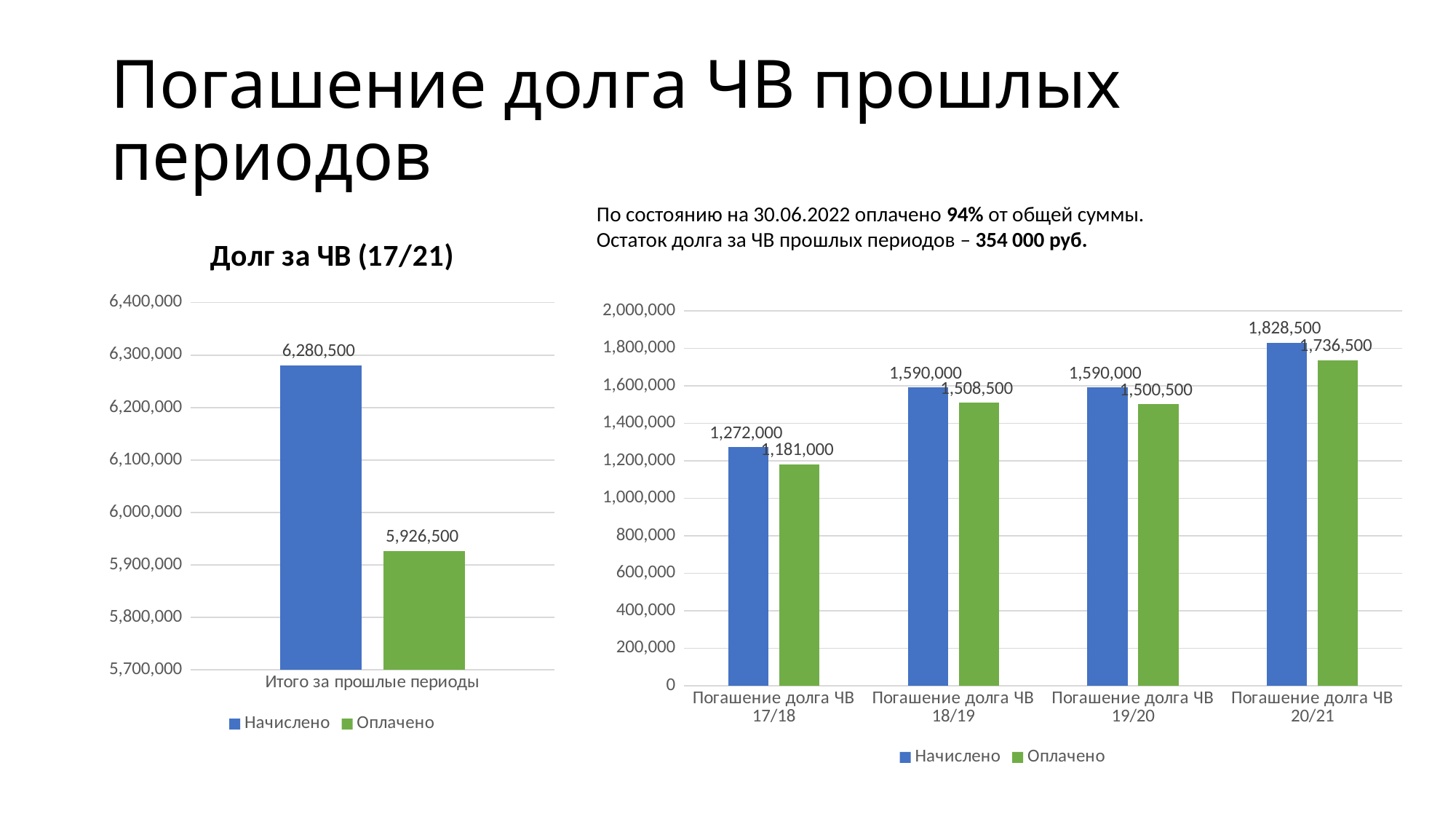
In the chart on the right, what is the Оплачено value for Погашение долга ЧВ 17/18? 1,181,000 In the chart titled "Долг за ЧВ (17/21)", what is the value for Оплачено? 5,926,500 What type of chart is the chart on the right? Bar chart In the chart titled "Долг за ЧВ (17/21)", what is the value for Начислено? 6,280,500 In the chart titled "Долг за ЧВ (17/21)", what is the difference between Начислено and Оплачено? 354,000 In the chart on the right, how many categories are shown on the x axis? 4 In the chart titled "Долг за ЧВ (17/21)", how many series does the legend list? 2 In the chart on the right, which is larger: the Оплачено value for Погашение долга ЧВ 18/19 or for Погашение долга ЧВ 19/20? Погашение долга ЧВ 18/19 In the chart on the right, what is the Начислено value for Погашение долга ЧВ 20/21? 1,828,500 In the chart on the right, what is the difference between Начислено and Оплачено for Погашение долга ЧВ 18/19? 81,500 In the chart on the right, which category has the highest Оплачено value? Погашение долга ЧВ 20/21 In the chart on the right, which category has the lowest Начислено value? Погашение долга ЧВ 17/18